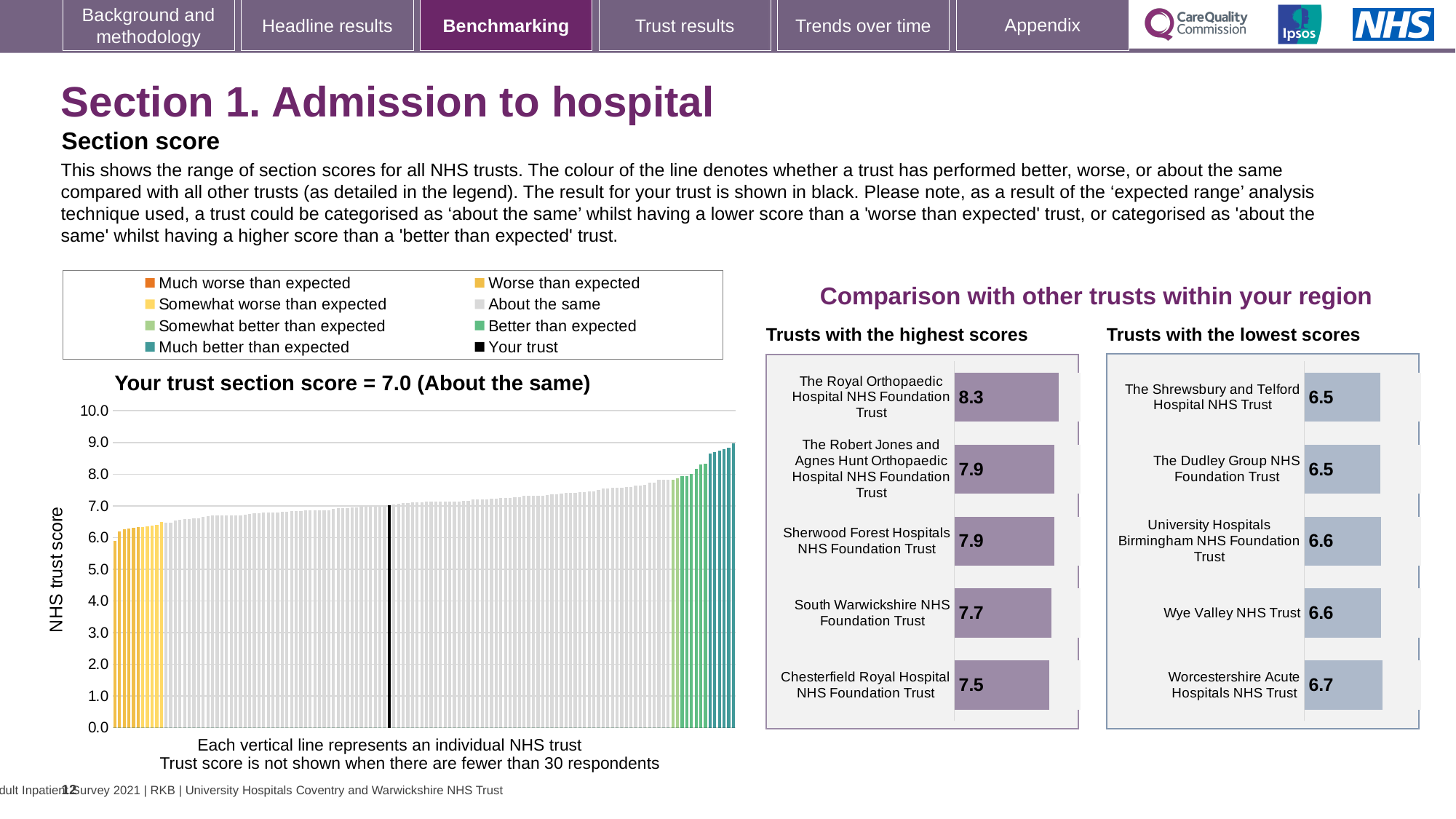
In the 'Trusts with the highest scores' chart, what is the score for The Royal Orthopaedic Hospital NHS Foundation Trust? 8.3 In the 'Your trust section score' chart, is the value of the tallest bar greater or less than 8.0? greater In the 'Trusts with the highest scores' chart, which has the larger score: Sherwood Forest Hospitals NHS Foundation Trust or South Warwickshire NHS Foundation Trust? Sherwood Forest Hospitals NHS Foundation Trust In the 'Trusts with the lowest scores' chart, what is the difference between the scores of Worcestershire Acute Hospitals NHS Trust and The Dudley Group NHS Foundation Trust? 0.2 What kind of chart is the 'Your trust section score' chart on the left of the slide? Bar chart In the 'Trusts with the lowest scores' chart, which trust has the highest score? Worcestershire Acute Hospitals NHS Trust In the 'Trusts with the highest scores' chart, what is the difference between the scores of The Royal Orthopaedic Hospital NHS Foundation Trust and Chesterfield Royal Hospital NHS Foundation Trust? 0.8 In the 'Your trust section score' chart, do the bar values rise or fall from left to right? Rise How many entries does the legend above the 'Your trust section score' chart list? 8 In the 'Trusts with the highest scores' chart, which trust has the lowest score? Chesterfield Royal Hospital NHS Foundation Trust In the 'Trusts with the lowest scores' chart, what is the score for Wye Valley NHS Trust? 6.6 How many trusts are shown in the 'Trusts with the lowest scores' chart? 5